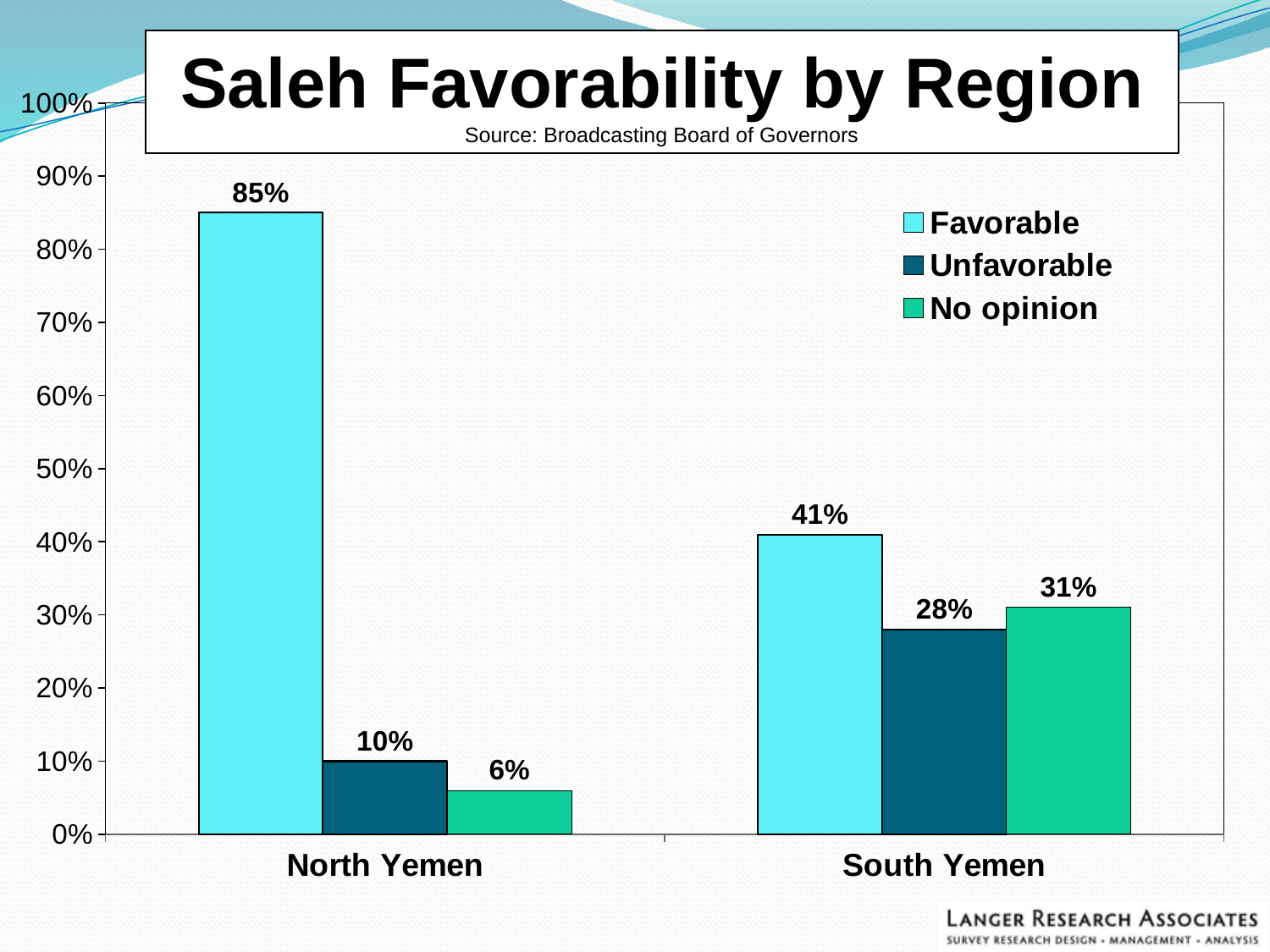
What is the Unfavorable value for South Yemen? 28% Which series has the lowest value for North Yemen? No opinion Which region has the higher Favorable value? North Yemen What is the Favorable value for South Yemen? 41% How many regions are shown on the x axis? 2 How many series does the legend list? 3 What is the source cited under the chart title? Broadcasting Board of Governors What is the difference between the No opinion values for South Yemen and North Yemen? 25% What is the difference between the Favorable values for North Yemen and South Yemen? 44% What kind of chart is shown on the slide? Bar chart What is the No opinion value for North Yemen? 6% What is the Favorable value for North Yemen? 85%